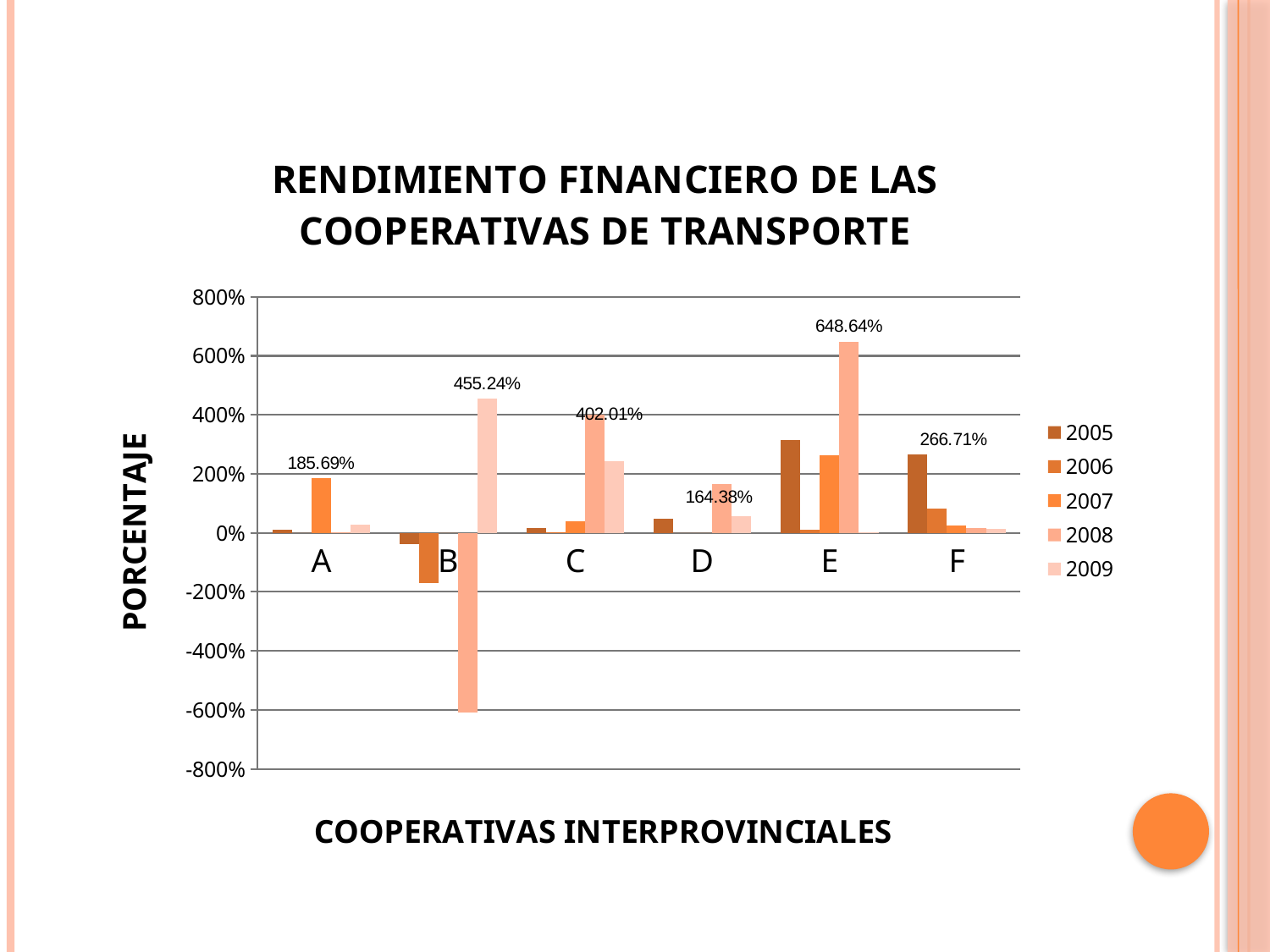
What kind of chart is shown on the slide? Bar chart Is the 2005 value for cooperative E greater or less than 200%? greater Which cooperative has the highest labelled value on the chart? E Which is larger: the labelled value for C in 2008 or the labelled value for F in 2005? C in 2008 Is the 2008 value for cooperative B greater or less than -400%? less How many cooperatives are shown on the x axis? 6 What is the labelled value for cooperative E in 2008? 648.64% What is the labelled value for cooperative A in 2007? 185.69% What is the difference between the labelled value for E (648.64%) and the labelled value for B (455.24%)? 193.40% Which cooperative has the lowest (most negative) bar on the chart? B What is the labelled value for cooperative F in 2005? 266.71% How many series does the legend list? 5